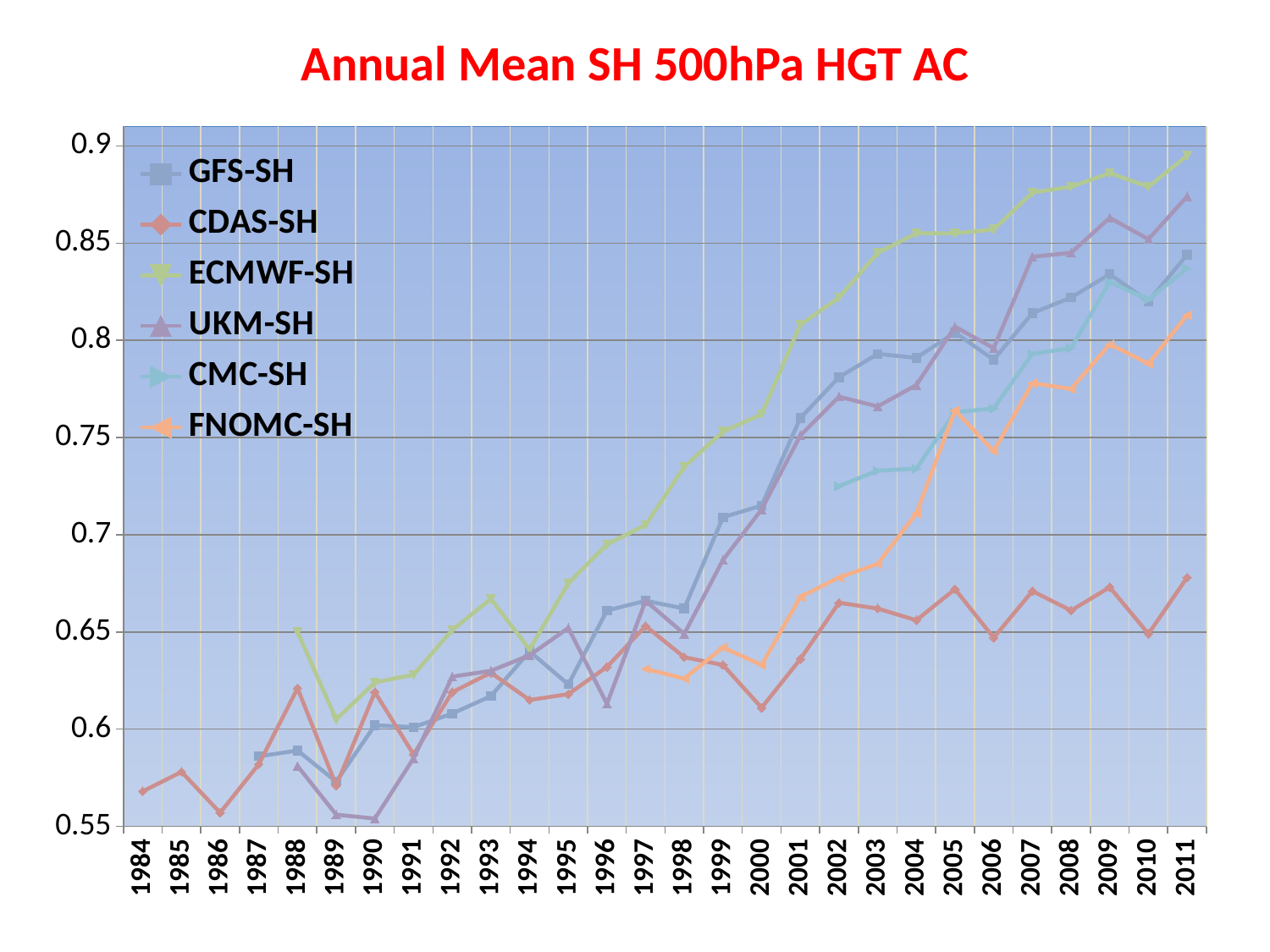
What is the title of the chart? Annual Mean SH 500hPa HGT AC Is the value for UKM-SH in 1990 greater or less than 0.6? less In 2011, which is larger: the value for UKM-SH or the value for GFS-SH? UKM-SH Does the ECMWF-SH series generally rise or fall from 1989 to 2011? rise Is the value for CDAS-SH in 2011 greater or less than 0.7? less In which year does the CMC-SH series first appear on the chart? 2002 Which series has the lowest value in 2011? CDAS-SH Is the value for ECMWF-SH in 2011 greater or less than 0.85? greater Which series has the highest value in 2011? ECMWF-SH How many years are shown along the x axis? 28 How many series does the legend list? 6 What kind of chart is shown on the slide? Line chart